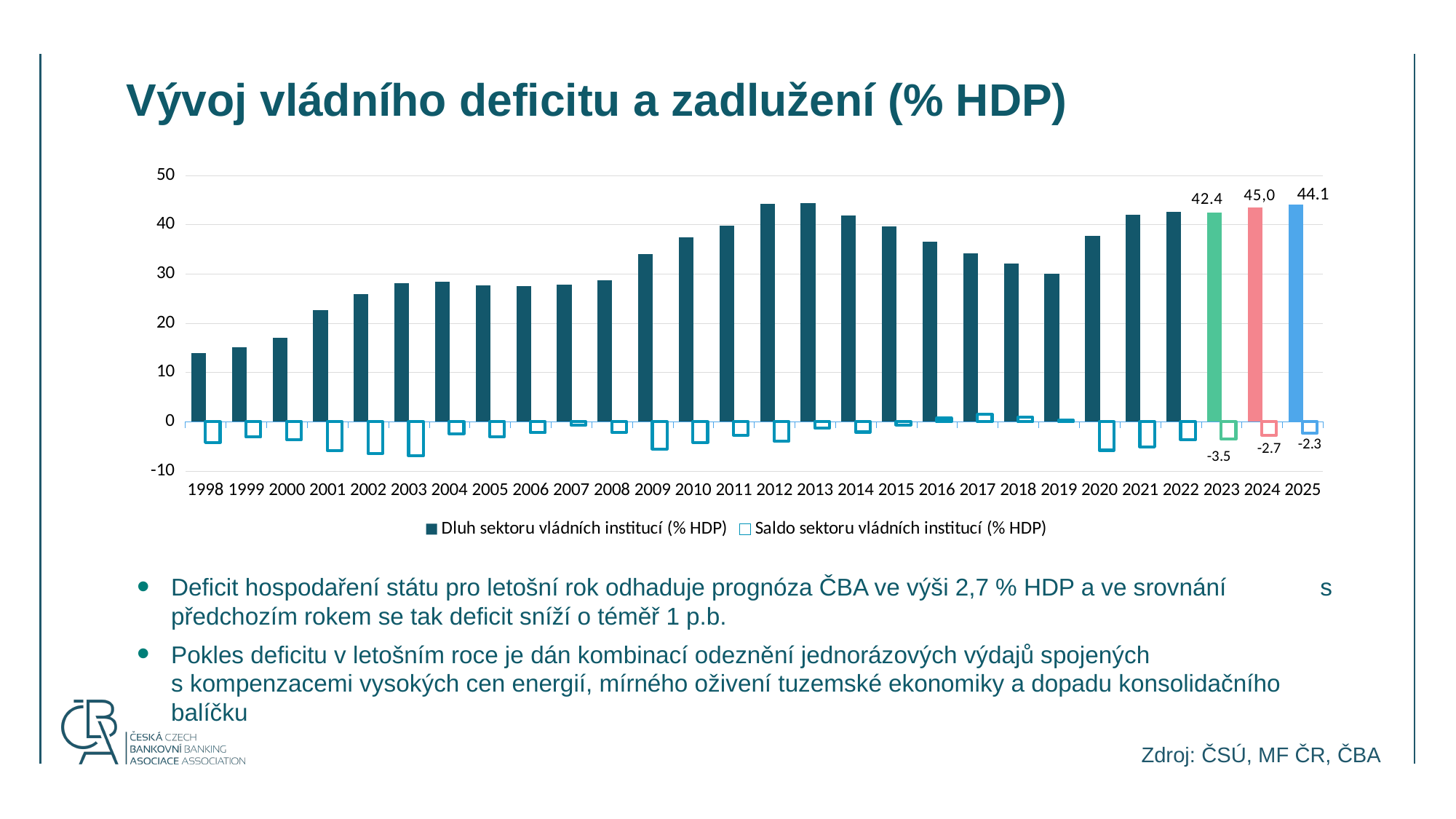
What is the value of Saldo sektoru vládních institucí (% HDP) for 2024? -2.7 What is the value of Saldo sektoru vládních institucí (% HDP) for 2025? -2.3 Is the debt (Dluh) value for 1998 greater or less than 20? less What is the value of Dluh sektoru vládních institucí (% HDP) for 2025? 44.1 How many years are shown on the x axis? 28 What is the value of Dluh sektoru vládních institucí (% HDP) for 2023? 42.4 How many series does the legend list? 2 What kind of chart is shown on the slide? Bar chart Is the debt (Dluh) value for 2013 greater or less than 40? greater What is the value of Dluh sektoru vládních institucí (% HDP) for 2024? 45,0